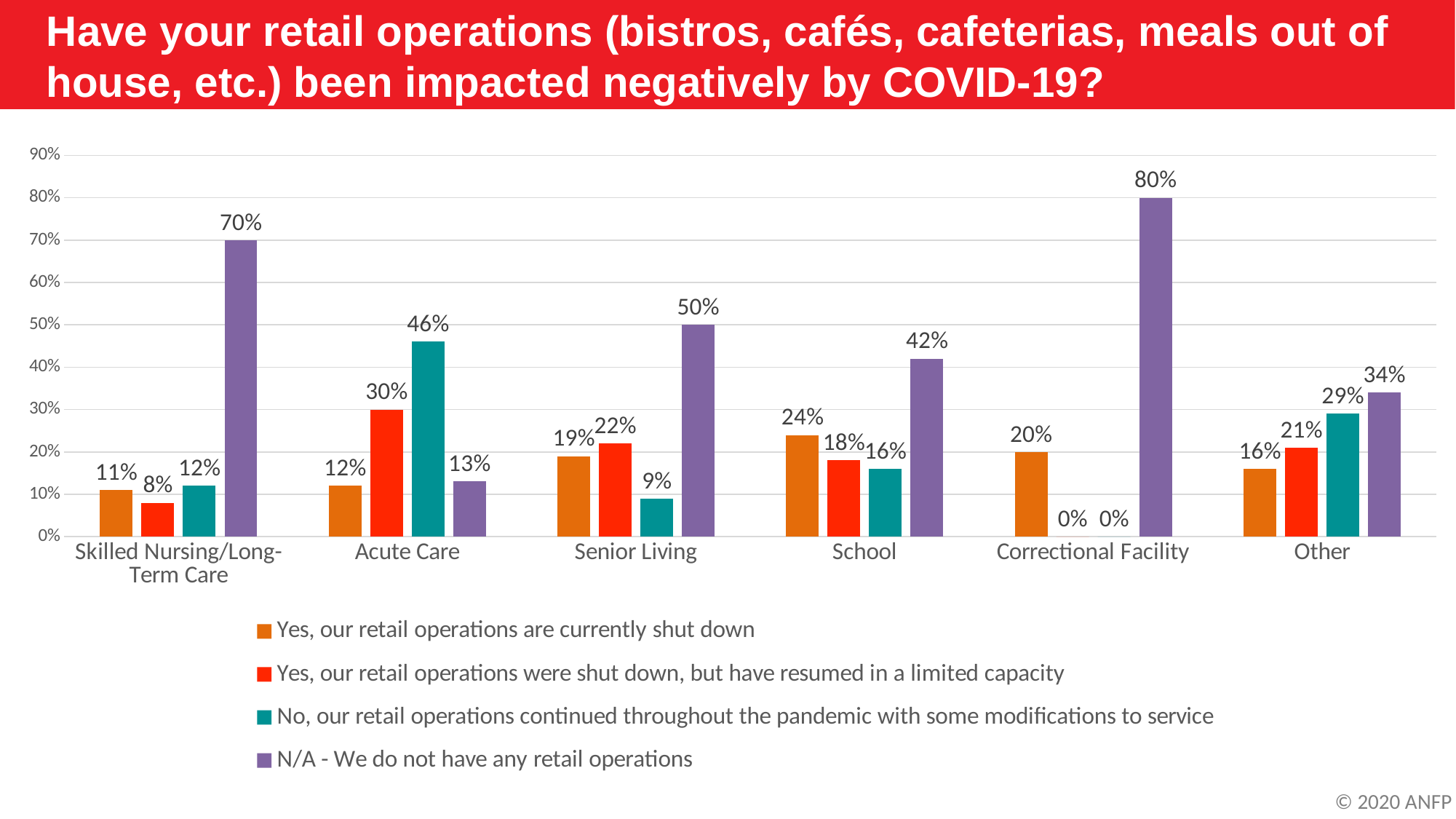
How many series does the legend list? 4 Which is larger for Other: "Yes, our retail operations are currently shut down" or "Yes, our retail operations were shut down, but have resumed in a limited capacity"? Yes, our retail operations were shut down, but have resumed in a limited capacity What is the difference between the "No, our retail operations continued throughout the pandemic" values for Acute Care and Senior Living? 37% How many categories are shown on the x axis? 6 What kind of chart is shown on the slide? Bar chart What percentage of Correctional Facility respondents answered "N/A - We do not have any retail operations"? 80% What colour represents "N/A - We do not have any retail operations" in the legend? Purple What is the difference between the "N/A" values for Skilled Nursing/Long-Term Care and Senior Living? 20% Which category has the highest value for "N/A - We do not have any retail operations"? Correctional Facility Which category has the lowest value for "Yes, our retail operations were shut down, but have resumed in a limited capacity"? Correctional Facility What percentage of School respondents said their retail operations are currently shut down? 24% What percentage of Acute Care respondents said their retail operations continued throughout the pandemic with some modifications to service? 46%